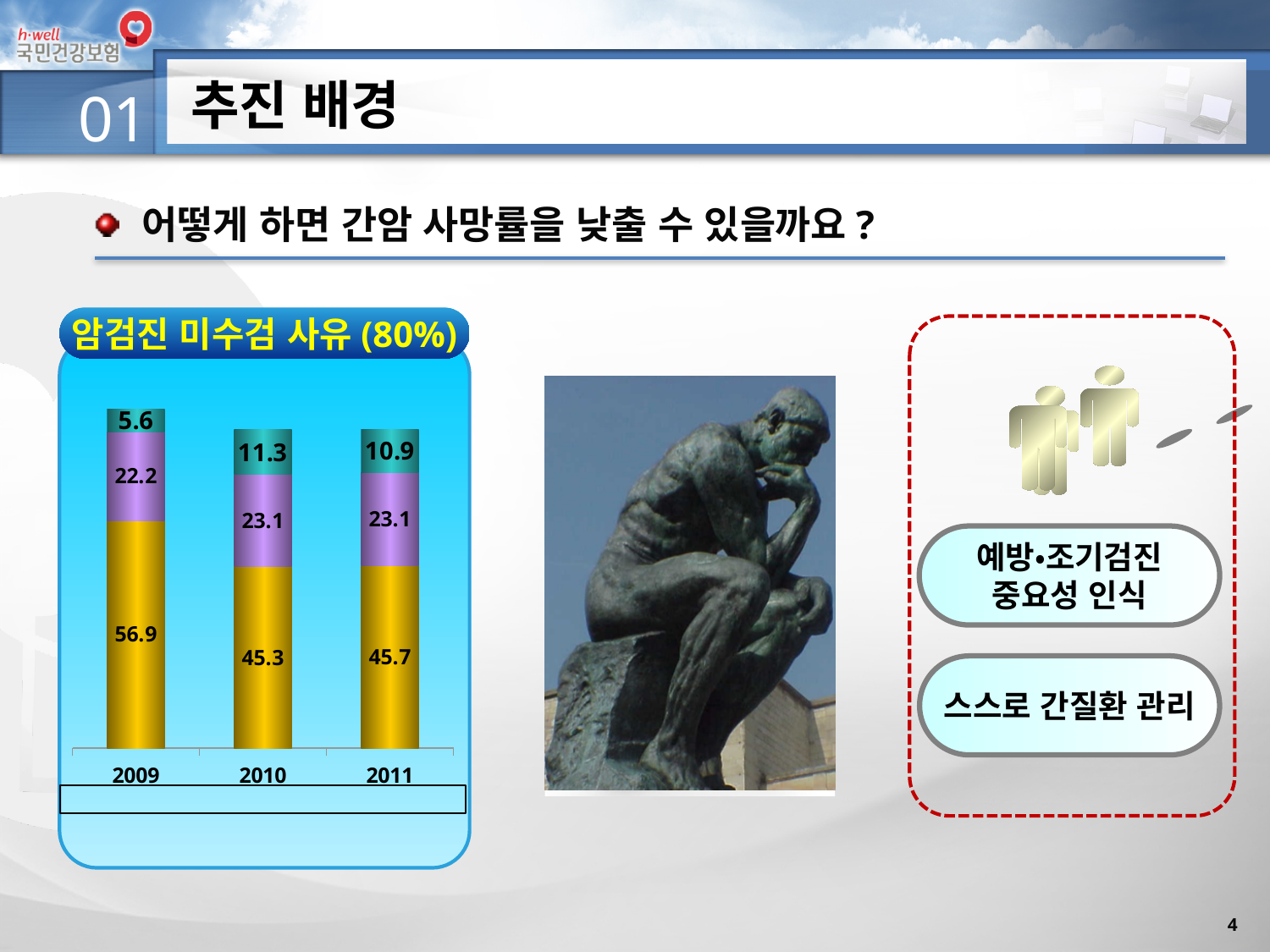
What is the total of the stacked bar for 2009? 84.7 Does the yellow (bottom) segment rise or fall from 2009 to 2010? fall What is the value of the yellow (bottom) segment for 2009? 56.9 What is the value of the teal (top) segment for 2010? 11.3 How many years (categories) are shown on the x axis of the chart? 3 What is the difference between the yellow segment values for 2009 and 2010? 11.6 In which year is the teal (top) segment the smallest? 2009 Which is larger, the teal segment for 2010 or the teal segment for 2011? 2010 What kind of chart is shown on the slide? stacked bar chart What is the title of the chart? 암검진 미수검 사유 (80%) What is the value of the purple (middle) segment for 2011? 23.1 In which year is the yellow (bottom) segment the largest? 2009